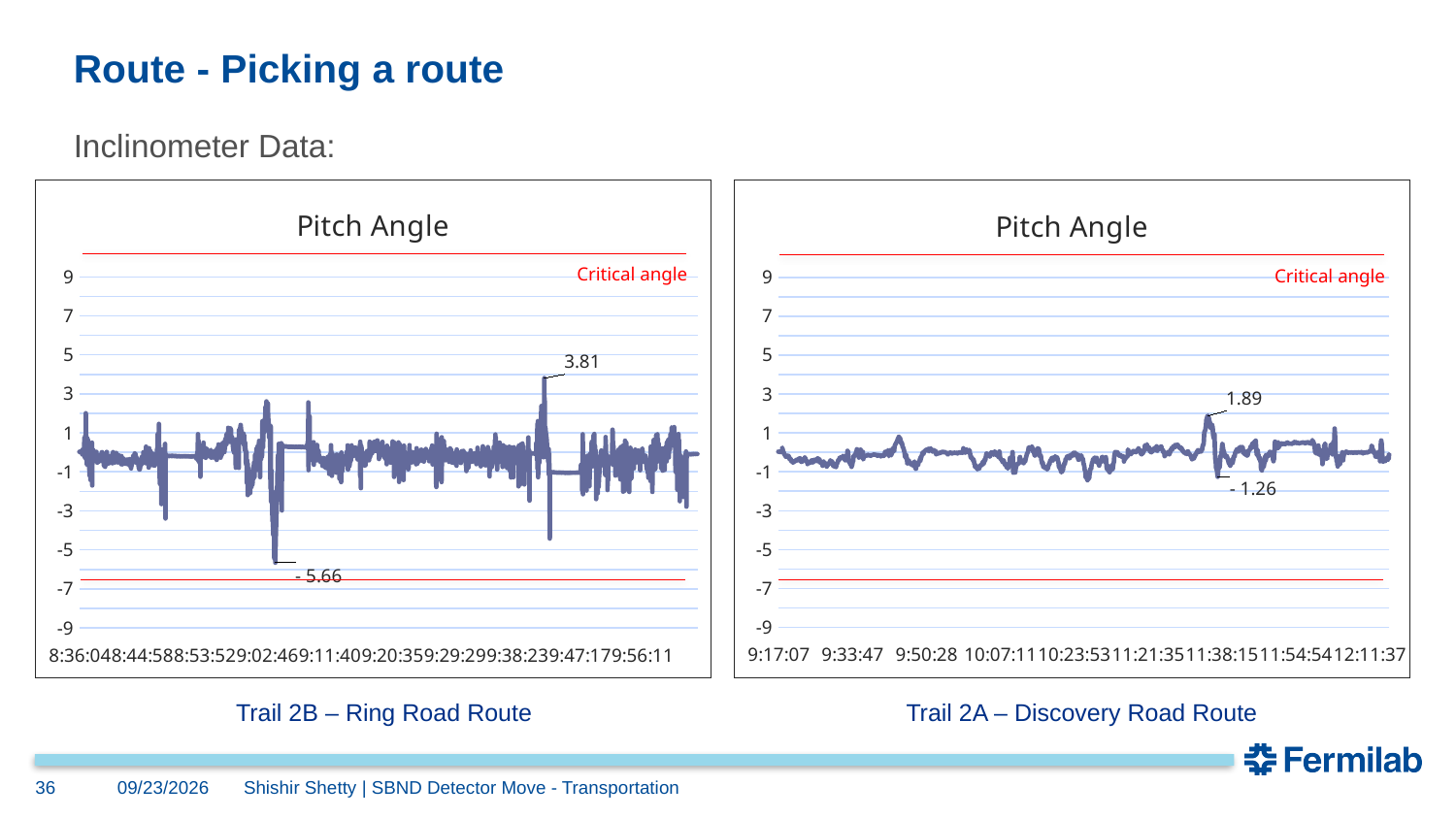
On the Trail 2B – Ring Road Route chart, what is the labelled minimum pitch angle? -5.66 On the Trail 2B – Ring Road Route chart, is the labelled peak value greater or less than 3? greater What kind of chart is the Trail 2B – Ring Road Route chart? line chart On the Trail 2B – Ring Road Route chart, what is the labelled maximum pitch angle? 3.81 Which route shows the larger labelled peak pitch angle, Trail 2B – Ring Road Route or Trail 2A – Discovery Road Route? Trail 2B – Ring Road Route On the Trail 2A – Discovery Road Route chart, what is the difference between the labelled maximum (1.89) and minimum (-1.26) pitch angles? 3.15 What is the title shown on both charts? Pitch Angle Which route shows the lower labelled minimum pitch angle, Trail 2B – Ring Road Route or Trail 2A – Discovery Road Route? Trail 2B – Ring Road Route On the Trail 2A – Discovery Road Route chart, what is the labelled maximum pitch angle? 1.89 On the Trail 2A – Discovery Road Route chart, what is the labelled minimum pitch angle? -1.26 On the Trail 2B – Ring Road Route chart, what is the difference between the labelled maximum (3.81) and minimum (-5.66) pitch angles? 9.47 What does the red line near the top of each chart represent, according to its label? Critical angle